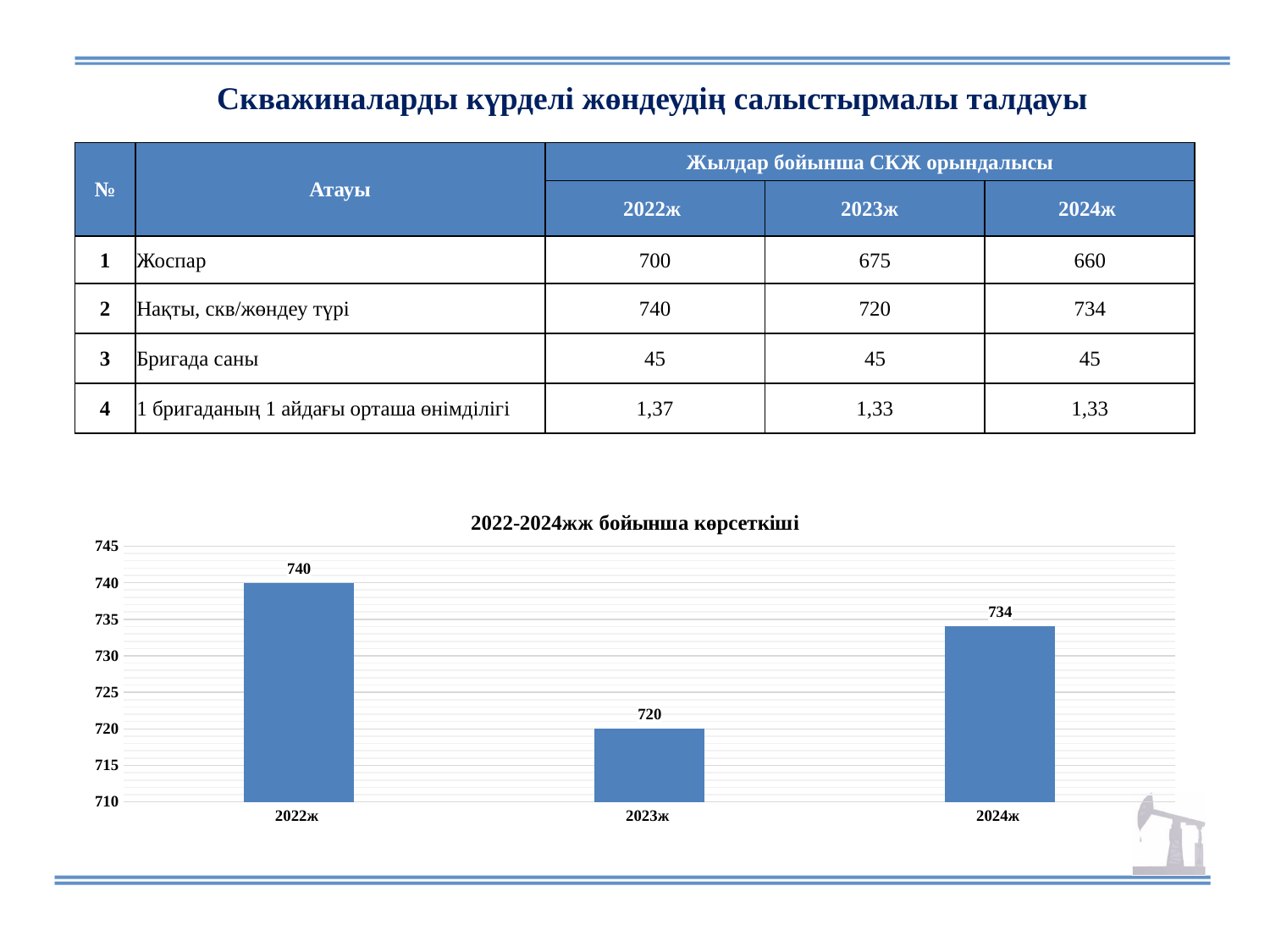
What is the value for 2024ж in the chart? 734 What is the value for 2022ж in the chart? 740 What is the difference between the values for 2024ж and 2023ж? 14 How many bars are shown in the chart? 3 Is the value for 2023ж greater or less than 725? less What kind of chart is shown on the slide? bar chart Which is larger, the value for 2022ж or the value for 2024ж? 2022ж Which year has the lowest value in the chart? 2023ж What is the title of the chart? 2022-2024жж бойынша көрсеткіші What is the value for 2023ж in the chart? 720 Which year has the highest value in the chart? 2022ж What is the difference between the values for 2022ж and 2023ж? 20